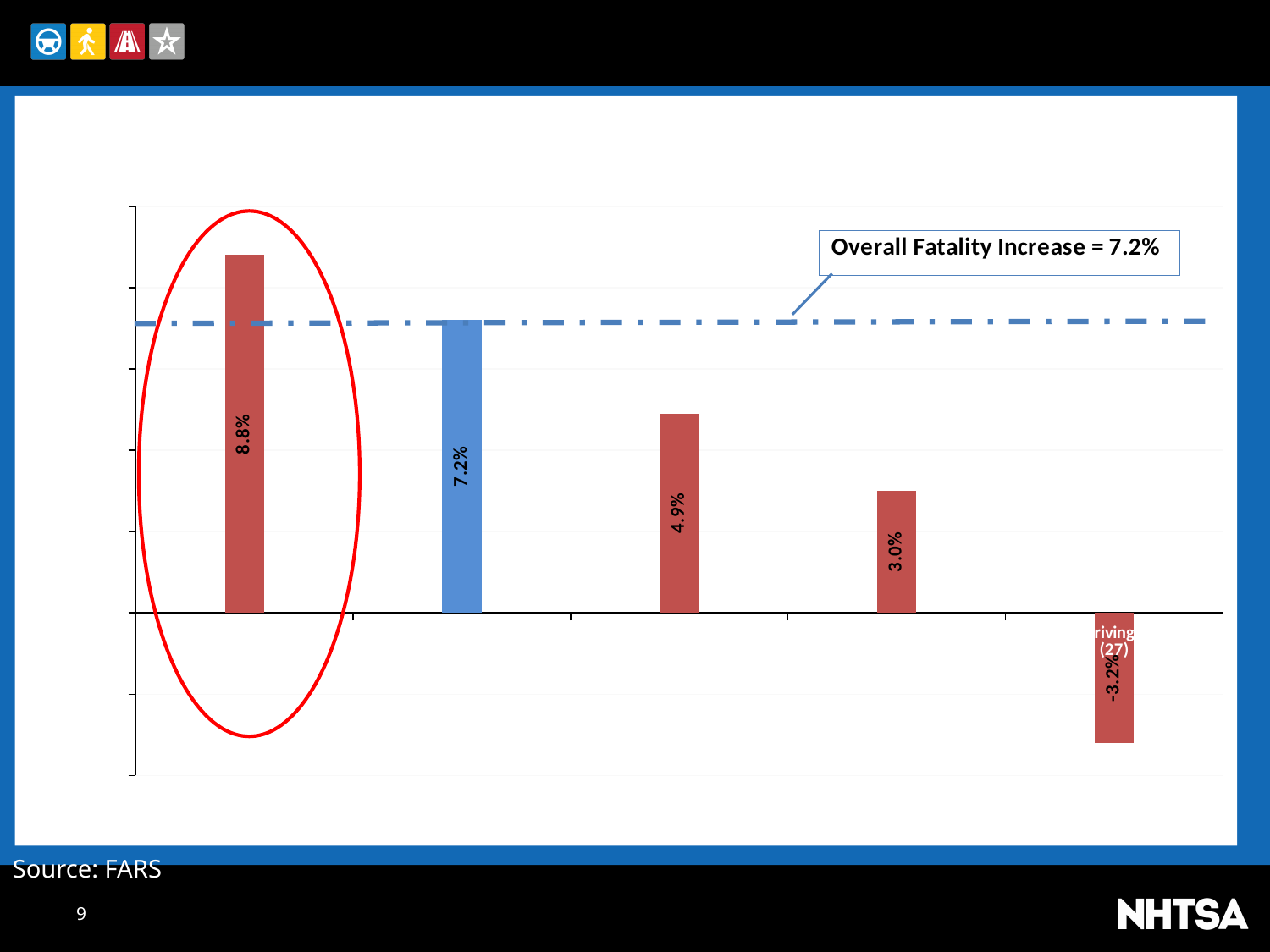
Which bar has the highest value? the first (leftmost) bar, 8.8% What overall fatality increase does the annotation box on the chart state? 7.2% What is the value shown on the first (leftmost) bar, the one circled in red? 8.8% Which bar has the lowest value? the rightmost bar, -3.2% What is the value shown on the rightmost bar, which extends below the axis? -3.2% What is the value shown on the blue bar? 7.2% By how many percentage points does the first bar (8.8%) exceed the blue bar (7.2%)? 1.6 percentage points What is the value shown on the fourth bar from the left? 3.0% What kind of chart is shown on the slide? bar chart How many bars are plotted in the chart? 5 Do the bar values rise or fall moving from left to right across the chart? fall What is the value shown on the third bar from the left? 4.9%